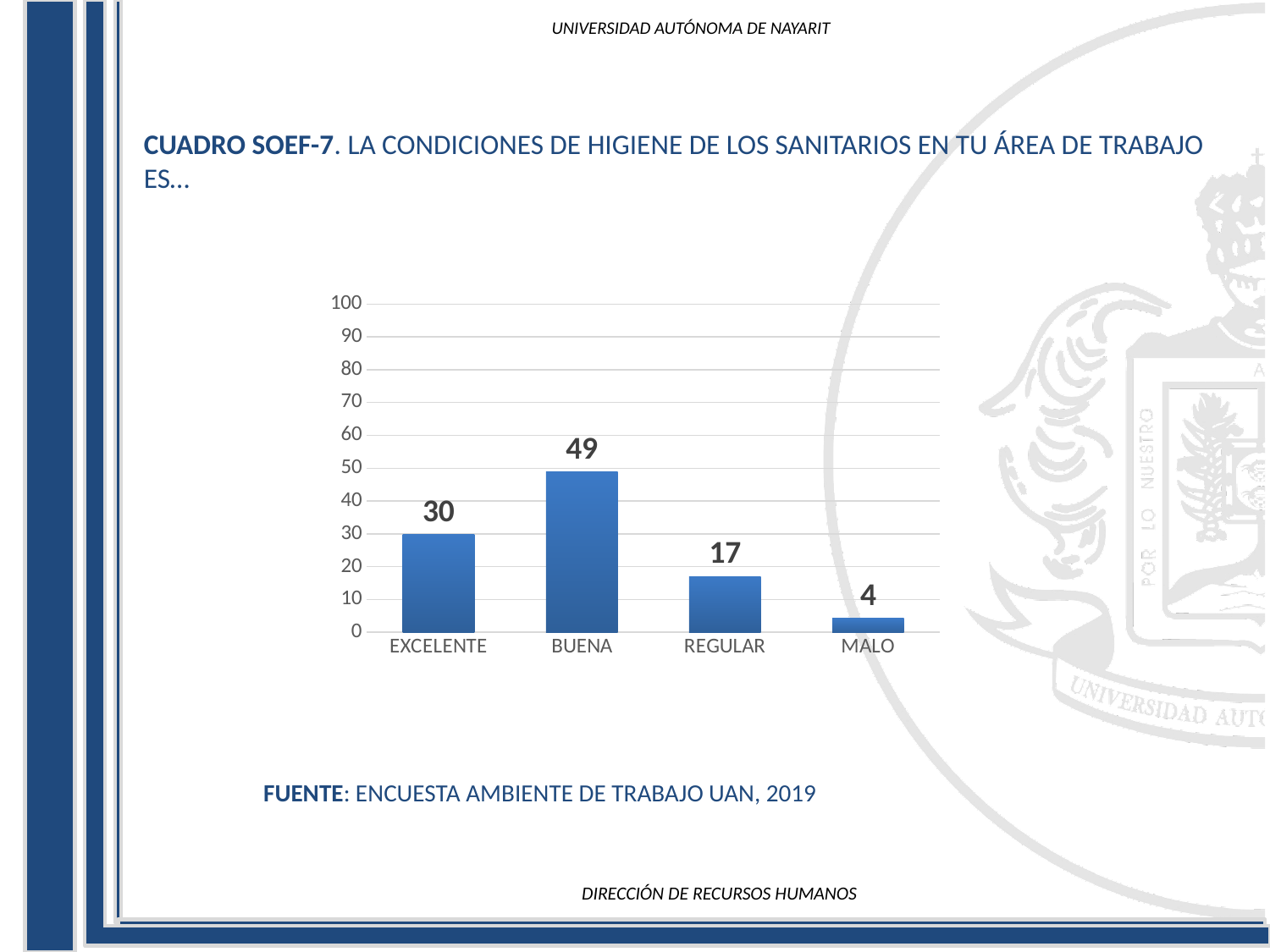
What is the highest value shown on the y axis? 100 What is the value for REGULAR? 17 What is the value for MALO? 4 What is the value for BUENA? 49 Which category has the lowest value? MALO Which is larger, the value for EXCELENTE or the value for REGULAR? EXCELENTE Which category has the highest value? BUENA What is the value for EXCELENTE? 30 What is the difference between the values for BUENA and EXCELENTE? 19 How many categories are shown on the x axis? 4 What is the difference between the values for REGULAR and MALO? 13 What kind of chart is shown on the slide? bar chart